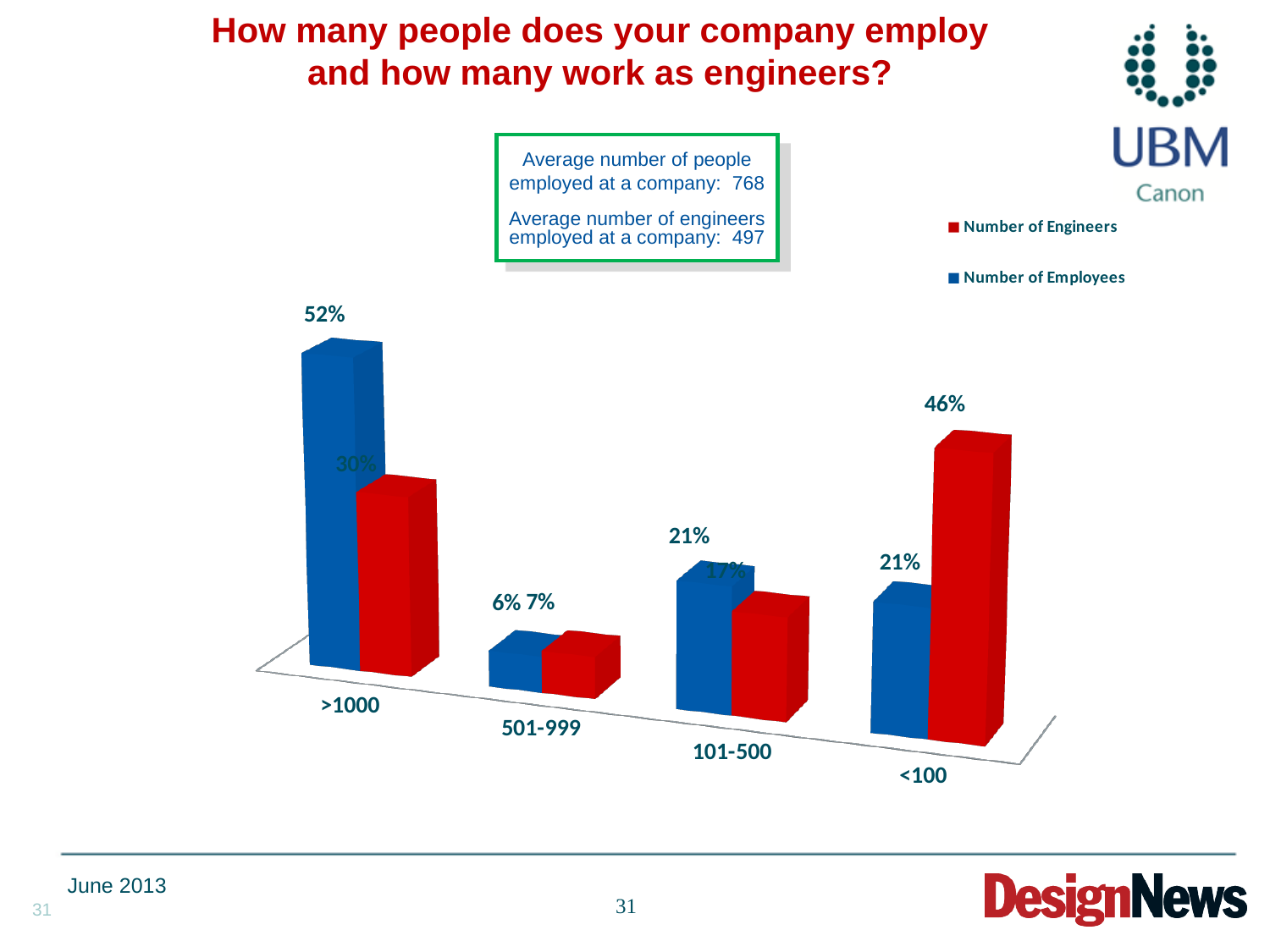
How many series does the legend list? 2 Which category has the highest Number of Employees value? >1000 What kind of chart is shown on the slide? bar chart What is the Number of Employees value for the 501-999 category? 6% How many company-size categories are shown on the x axis? 4 What is the Number of Engineers value for the >1000 category? 30% What is the Number of Employees value for the >1000 category? 52% Which series is shown in red in the legend? Number of Engineers What is the difference between the Number of Employees and Number of Engineers values for the <100 category? 25% Which category has the lowest Number of Engineers value? 501-999 What is the Number of Engineers value for the 501-999 category? 7% What is the Number of Engineers value for the <100 category? 46%